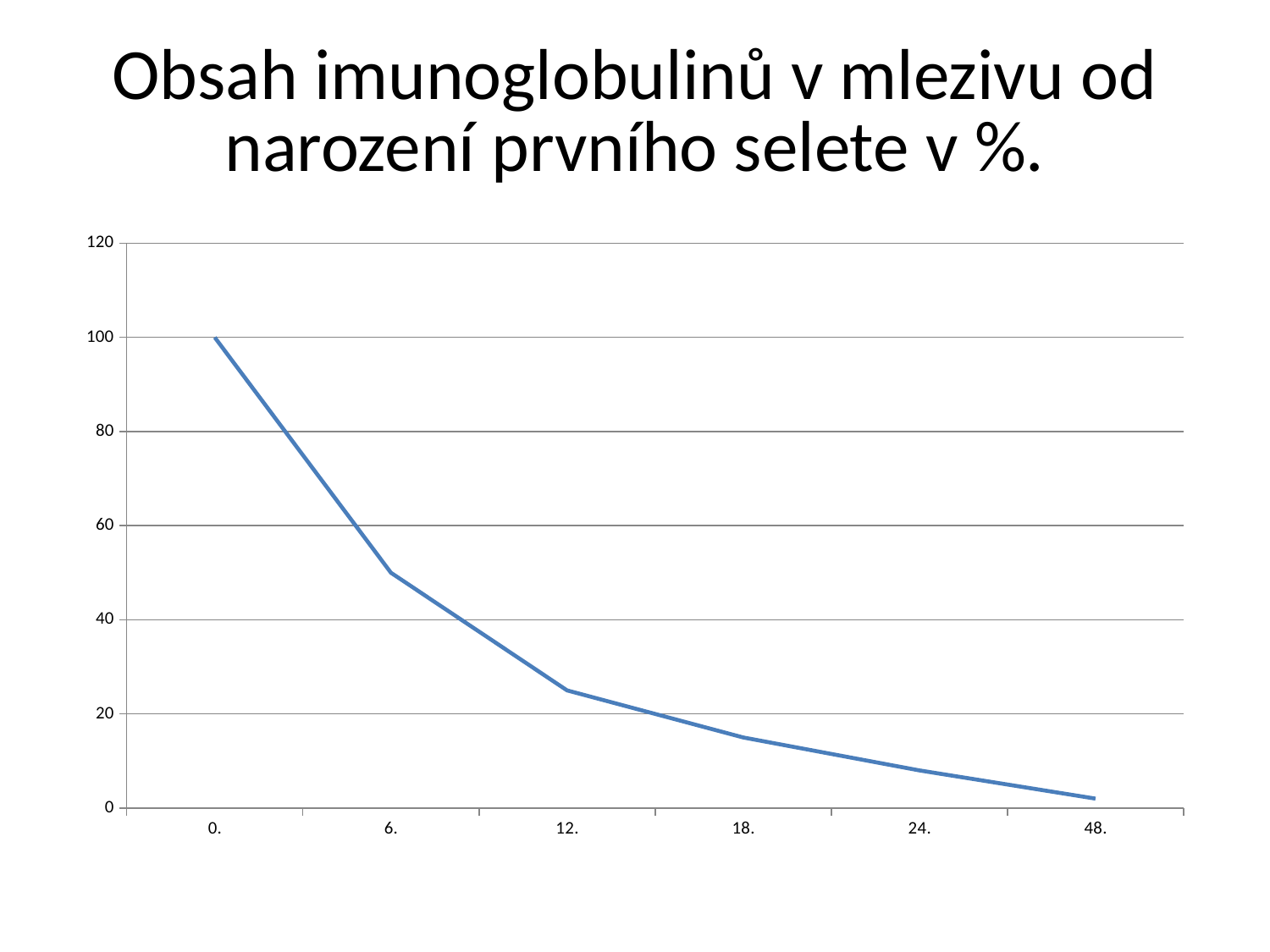
How many data points are plotted on the line? 6 Is the value for 48. greater or less than 20? less What kind of chart is shown on the slide? line chart Do the values rise or fall along the x axis? fall Which category has the lowest value? 48. What is the value at category 0.? 100 Is the value for 18. greater or less than 20? less Is the value for 12. greater or less than 20? greater Which category has the highest value? 0. What is the title of the chart? Obsah imunoglobulinů v mlezivu od narození prvního selete v %. Which is larger, the value for 6. or the value for 24.? 6.